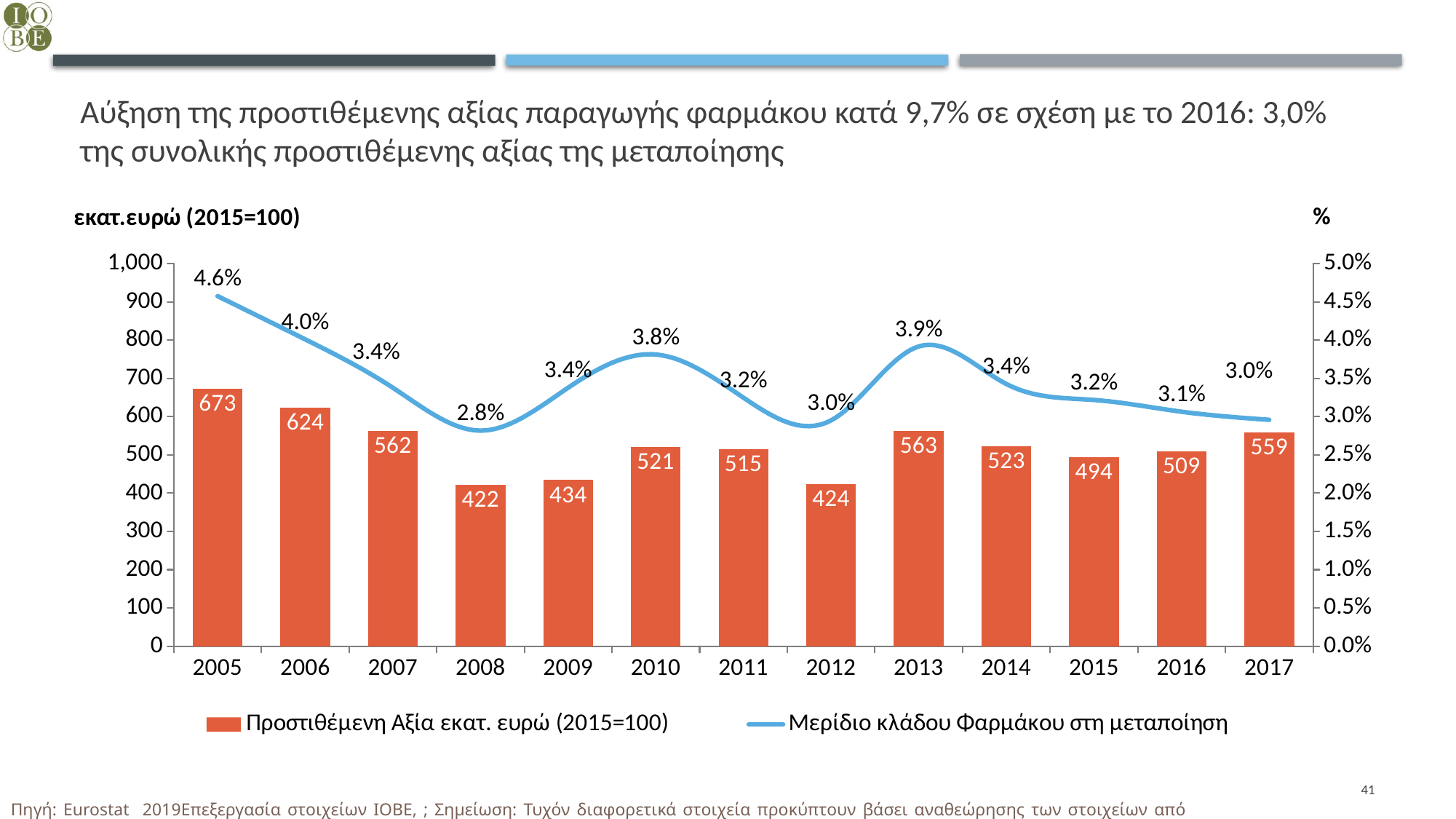
What kinds of chart are combined on this slide? Bar chart and line chart How many years are shown on the x axis? 13 Which year has the highest value of Προστιθέμενη Αξία εκατ. ευρώ (2015=100)? 2005 What is the value of Προστιθέμενη Αξία εκατ. ευρώ (2015=100) for 2017? 559 What is the Μερίδιο κλάδου Φαρμάκου στη μεταποίηση for 2013? 3.9% Does the Μερίδιο κλάδου Φαρμάκου στη μεταποίηση rise or fall from 2013 to 2017? Fall Which is larger, the Προστιθέμενη Αξία for 2013 or for 2014? 2013 Which year has the lowest Μερίδιο κλάδου Φαρμάκου στη μεταποίηση? 2008 What is the label of the left vertical axis? εκατ.ευρώ (2015=100) What is the difference between the Προστιθέμενη Αξία values for 2005 and 2008? 251 How many series does the legend list? 2 What is the Μερίδιο κλάδου Φαρμάκου στη μεταποίηση for 2008? 2.8%